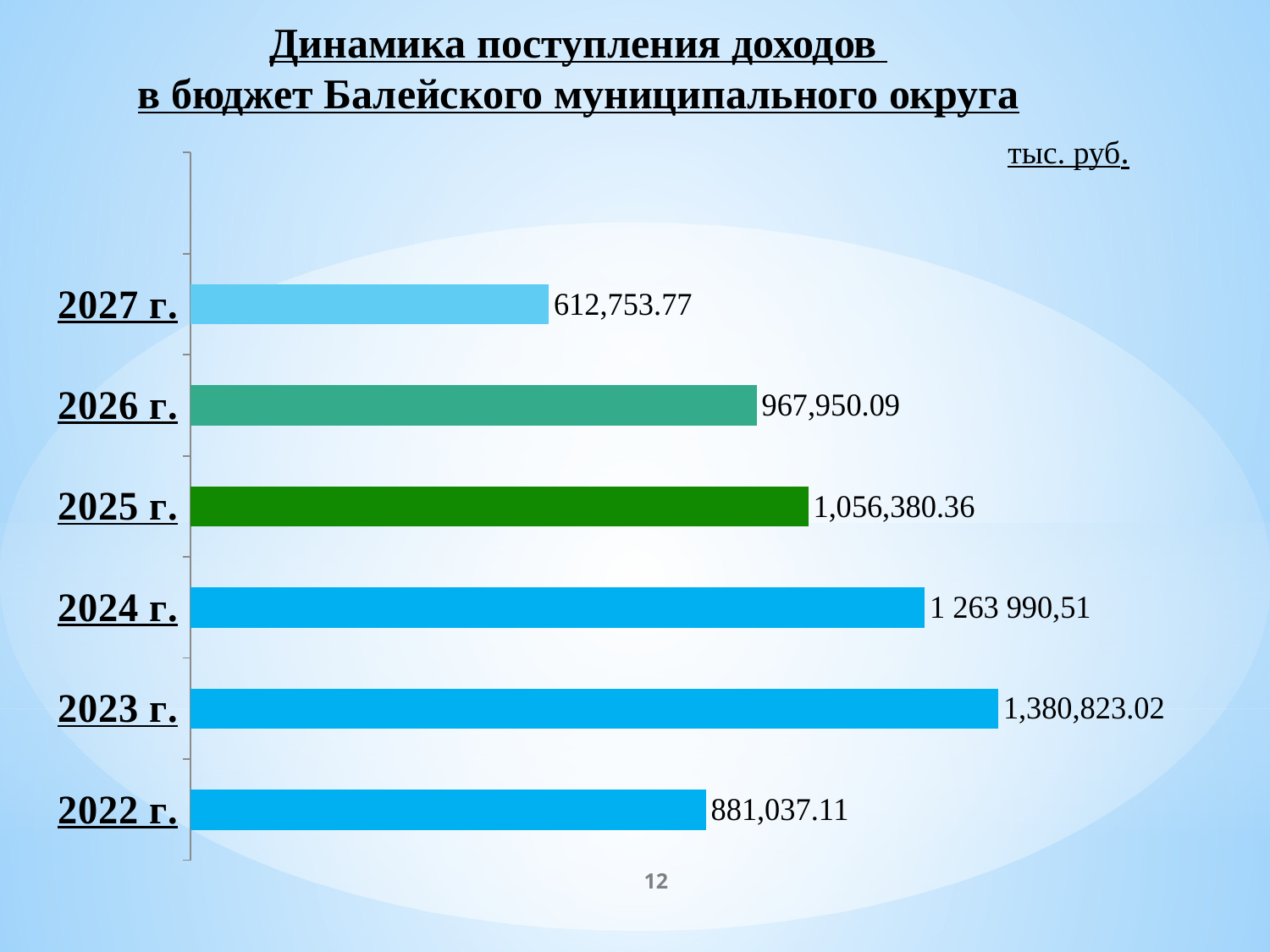
Which is larger, the value for 2025 г. or the value for 2026 г.? 2025 г. What is the value for 2023 г.? 1,380,823.02 What unit is indicated for the values in the chart? тыс. руб. How many years (bars) are shown in the chart? 6 What is the difference between the values for 2026 г. and 2027 г.? 355,196.32 What kind of chart is shown on the slide? Bar chart What is the value for 2027 г.? 612,753.77 What is the value for 2022 г.? 881,037.11 What is the difference between the values for 2023 г. and 2022 г.? 499,785.91 Which year has the lowest value? 2027 г. Which year has the highest value? 2023 г. What is the value for 2024 г.? 1 263 990,51